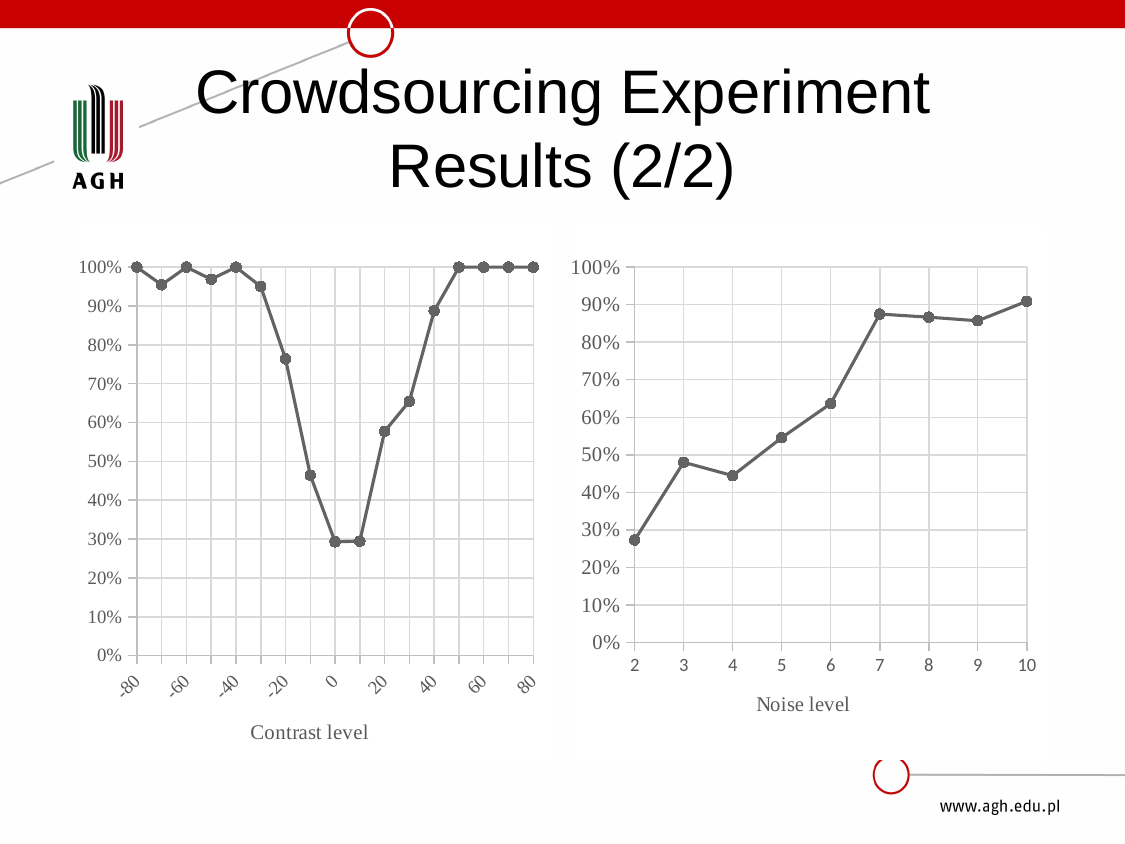
In the chart with the x axis labelled Contrast level, what is the value at contrast level 80? 100% In the chart with the x axis labelled Noise level, is the value at noise level 7 greater or less than 80%? greater In the chart with the x axis labelled Noise level, is the value at noise level 2 greater or less than 30%? less In the chart with the x axis labelled Contrast level, how many data points are plotted? 17 In the chart with the x axis labelled Noise level, how many data points are plotted? 9 In the chart with the x axis labelled Contrast level, is the value at contrast level -20 greater or less than 70%? greater In the chart with the x axis labelled Noise level, which noise level has the highest value? 10 In the chart with the x axis labelled Noise level, do the values generally rise or fall as the noise level increases from 2 to 10? rise In the chart with the x axis labelled Noise level, which noise level has the lowest value? 2 What kind of chart is the chart with the x axis labelled Contrast level? line chart In the chart with the x axis labelled Contrast level, what is the value at contrast level -80? 100%